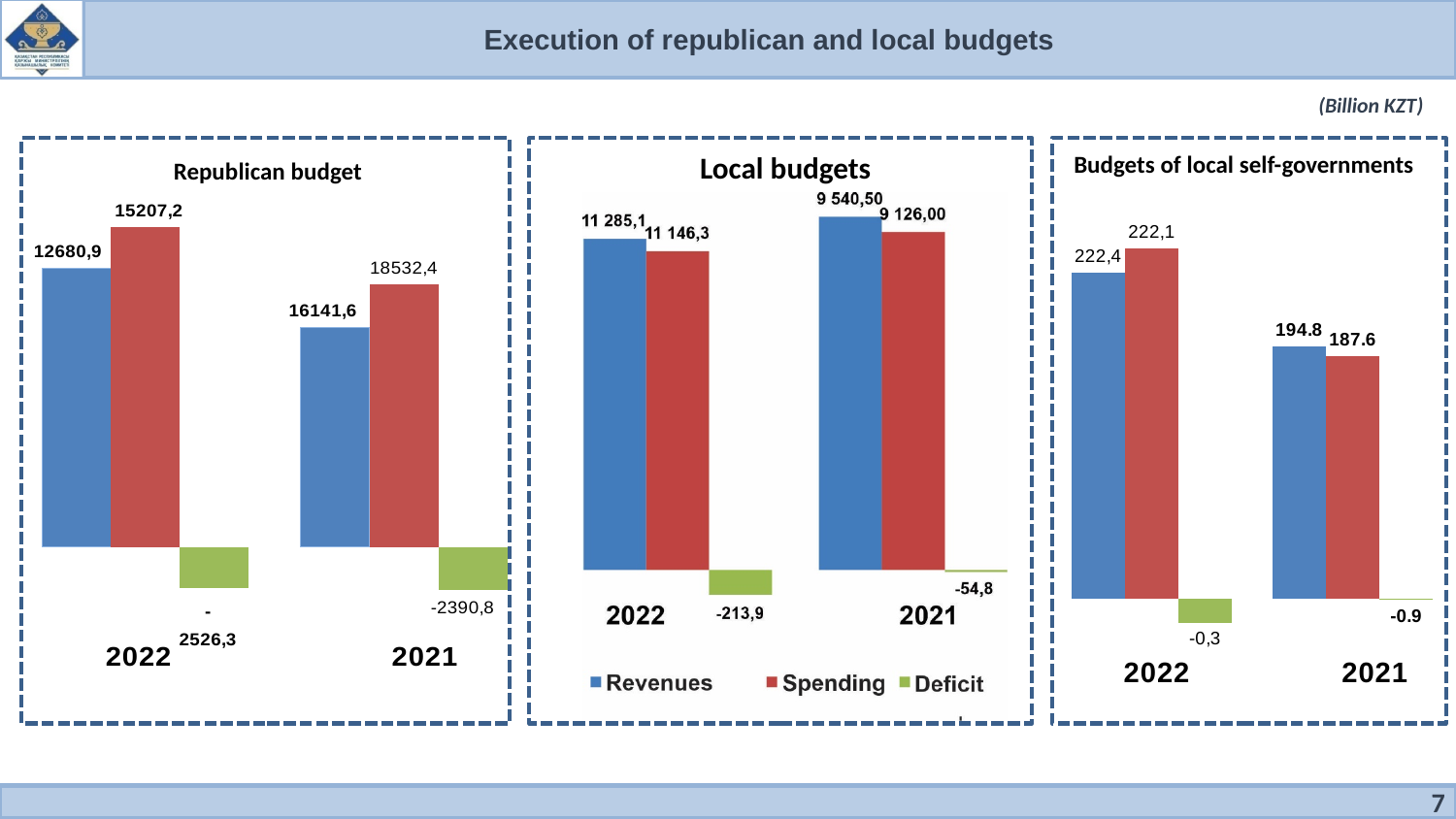
How many years are shown on the x axis of the Budgets of local self-governments chart? 2 In the Local budgets chart, what is the Revenues value for 2022? 11 285,1 In the Budgets of local self-governments chart, what is the value of the green (Deficit) bar for 2022? -0,3 In the Local budgets chart, what is the Spending value for 2021? 9 126,00 How many series does the legend on the Local budgets chart list? 3 In the Local budgets chart, which year has the smaller Deficit value? 2021 What unit is stated for the values on the slide? Billion KZT What type of chart is the Republican budget chart? Bar chart In the Local budgets chart, which is larger for 2022: Revenues or Spending? Revenues In the Republican budget chart, what is the difference between the Spending and Revenues values for 2022? 2526,3 In the Republican budget chart, what is the value of the red (Spending) bar for 2021? 18532,4